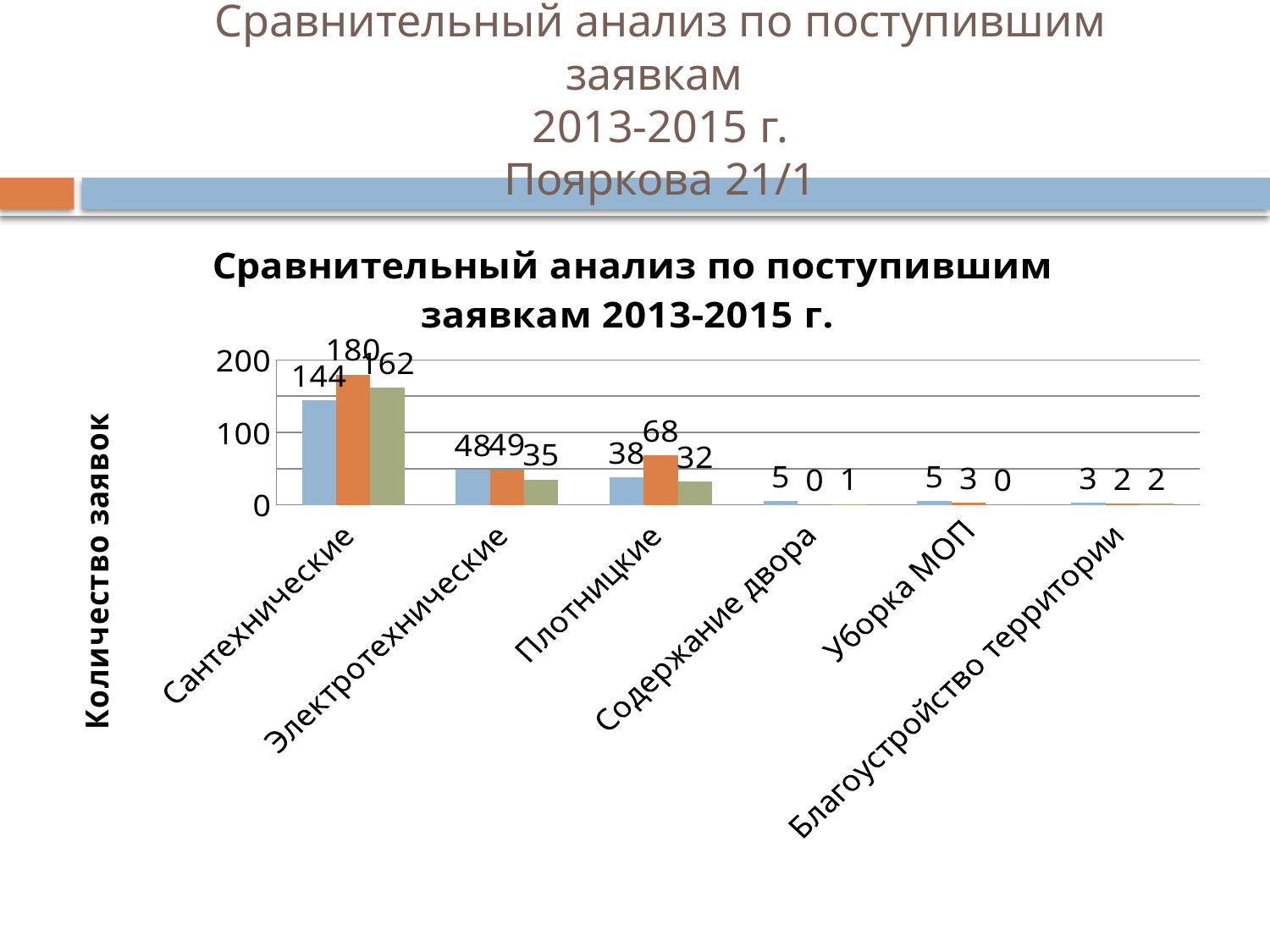
What is the value of the green bar for Электротехнические? 35 How many categories are shown on the x axis? 6 What is the value of the orange bar for Сантехнические? 180 What kind of chart is shown on the slide? bar chart Which category has the highest orange bar? Сантехнические What is the value of the blue bar for Плотницкие? 38 What is the total of the three bars for Благоустройство территории? 7 What is the difference between the orange and blue bars for Сантехнические? 36 Which is larger for Плотницкие: the orange bar or the green bar? the orange bar What is the label of the vertical axis? Количество заявок Which category has the lowest green bar? Уборка МОП Is the value of the green bar for Сантехнические greater or less than 100? greater